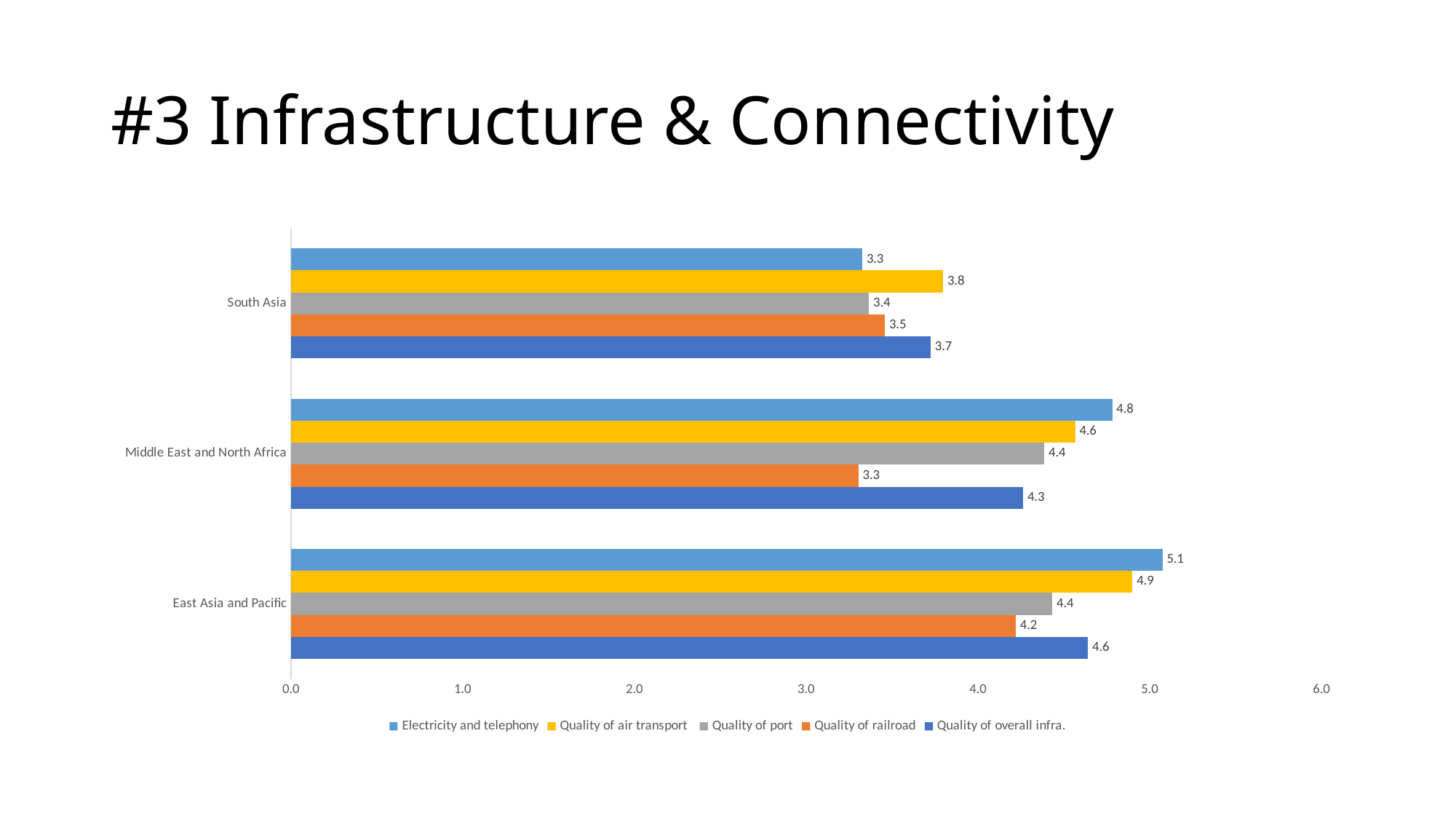
What is the value for Quality of air transport in South Asia? 3.8 Which series has the lowest value in South Asia? Electricity and telephony What is the value for Electricity and telephony in East Asia and Pacific? 5.1 What kind of chart is shown on the slide? bar chart What is the value for Quality of railroad in Middle East and North Africa? 3.3 How many regions are shown on the chart? 3 How many series does the legend list? 5 What is the difference between Electricity and telephony in East Asia and Pacific and in South Asia? 1.8 Which region has the highest value for Quality of overall infra.? East Asia and Pacific Which is larger: Quality of port in Middle East and North Africa or Quality of port in South Asia? Middle East and North Africa Is the value for Quality of railroad in East Asia and Pacific greater or less than 4.0? greater What colour are the Quality of air transport bars? yellow